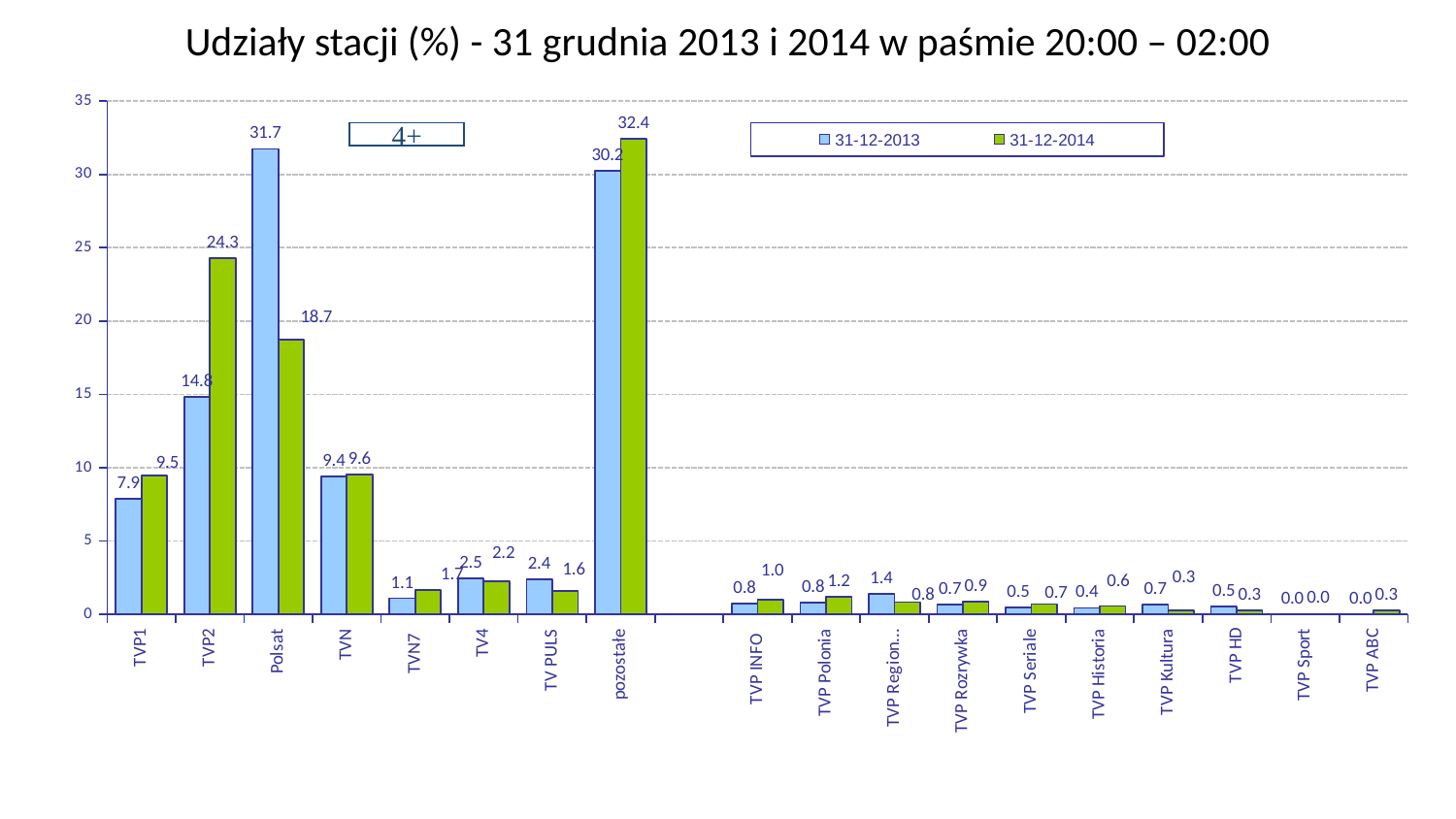
What kind of chart is shown on the slide? Bar chart How many series does the legend list? 2 Which is larger for TV PULS: the 31-12-2013 value or the 31-12-2014 value? 31-12-2013 How many categories are shown on the x axis? 18 Which is larger for TVP2: the 31-12-2013 value or the 31-12-2014 value? 31-12-2014 What is the value for TVP Kultura in the 31-12-2013 series? 0.7 What is the value for Polsat in the 31-12-2013 series? 31.7 Which category has the highest value in the 31-12-2014 series? pozostałe What is the value for TVP2 in the 31-12-2014 series? 24.3 Which category has the highest value in the 31-12-2013 series? Polsat What is the value for pozostałe in the 31-12-2014 series? 32.4 What is the difference between the 31-12-2013 and 31-12-2014 values for Polsat? 13.0